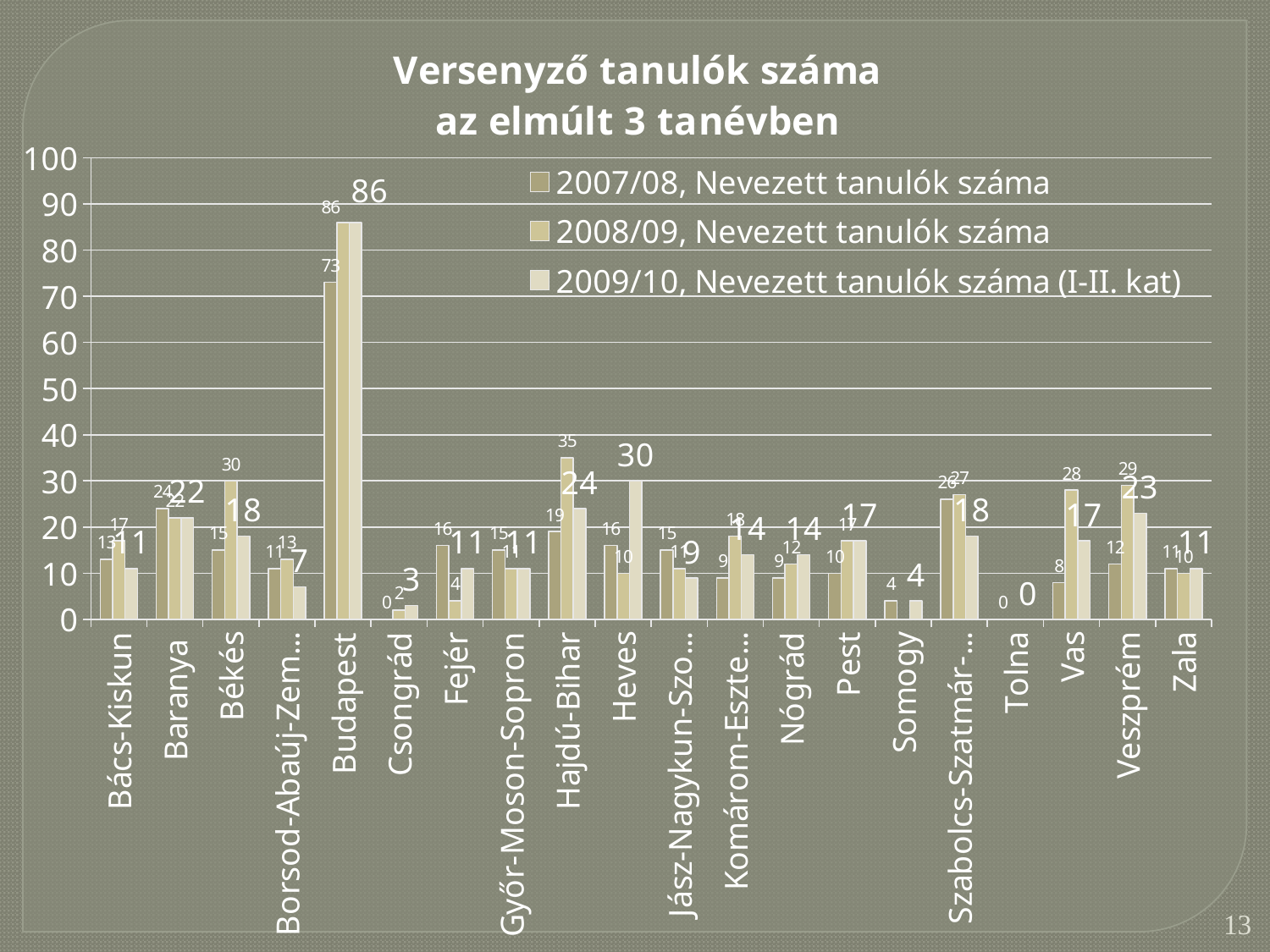
What is the value for Heves in the 2009/10, Nevezett tanulók száma (I-II. kat) series? 30 What is the value for Vas in the 2007/08, Nevezett tanulók száma series? 8 Which county has the highest value in the 2009/10, Nevezett tanulók száma (I-II. kat) series? Budapest What is the value for Budapest in the 2009/10, Nevezett tanulók száma (I-II. kat) series? 86 Which is larger: the 2008/09 value for Békés or the 2008/09 value for Vas? Békés What type of chart is shown on the slide? bar chart What is the difference between the 2008/09 and 2007/08 values for Budapest? 13 Which county has the lowest value in the 2009/10, Nevezett tanulók száma (I-II. kat) series? Tolna How many series does the legend list? 3 What is the value for Hajdú-Bihar in the 2008/09, Nevezett tanulók száma series? 35 How many counties (categories) are shown on the x axis? 20 What is the title of the chart? Versenyző tanulók száma az elmúlt 3 tanévben